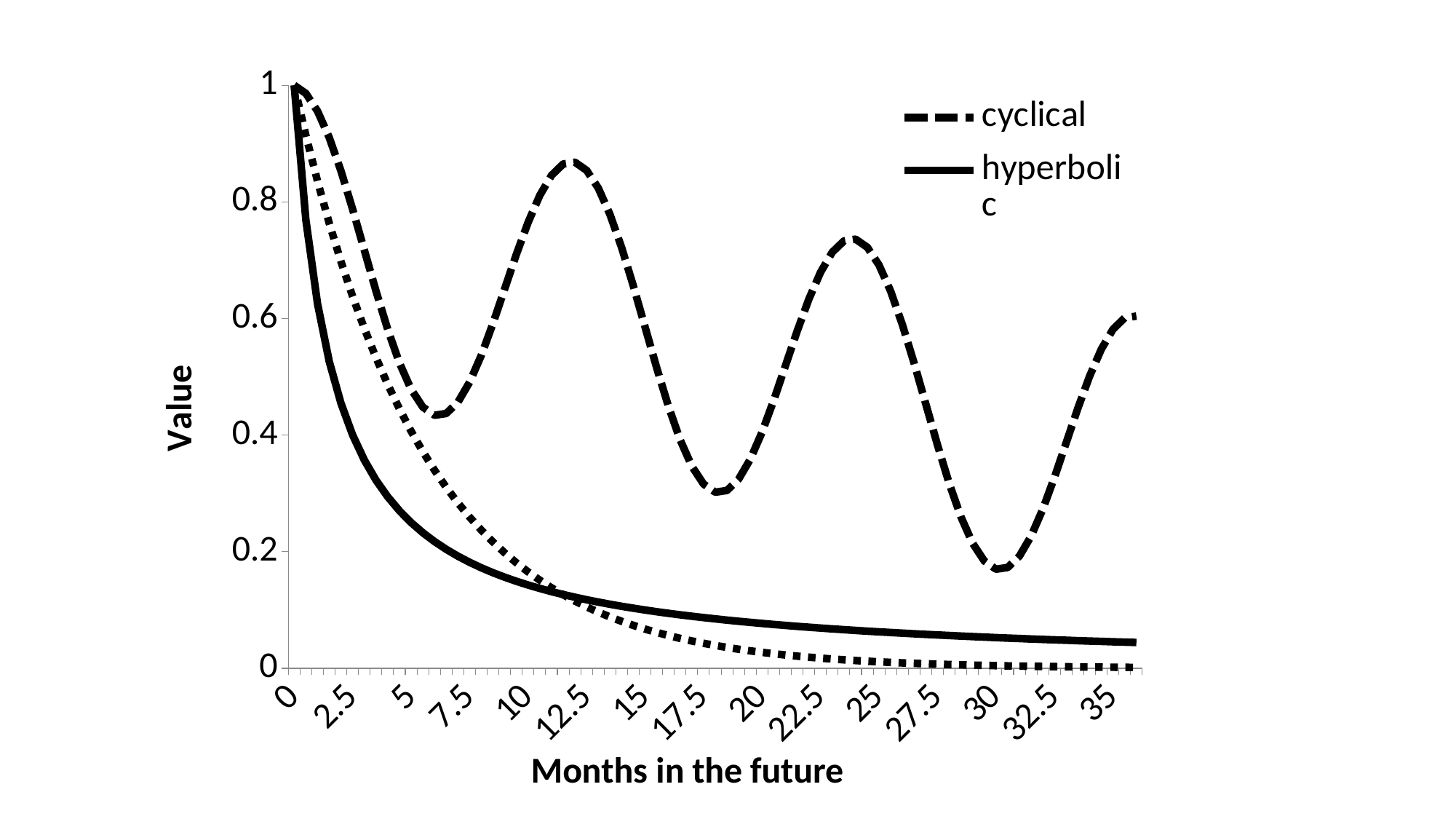
Is the value of the hyperbolic series at month 5 greater or less than 0.4? less Is the value of the cyclical series at month 17.5 greater or less than 0.4? less What is the title of the x axis? Months in the future Does the hyperbolic series rise or fall as months in the future increase? fall Is the value of the cyclical series at month 12.5 greater or less than 0.8? greater What kind of chart is shown on the slide? line chart How many series does the legend list? 2 At month 25, which series has the larger value, cyclical or hyperbolic? cyclical What is the title of the y axis? Value What is the value of the hyperbolic series at month 0? 1